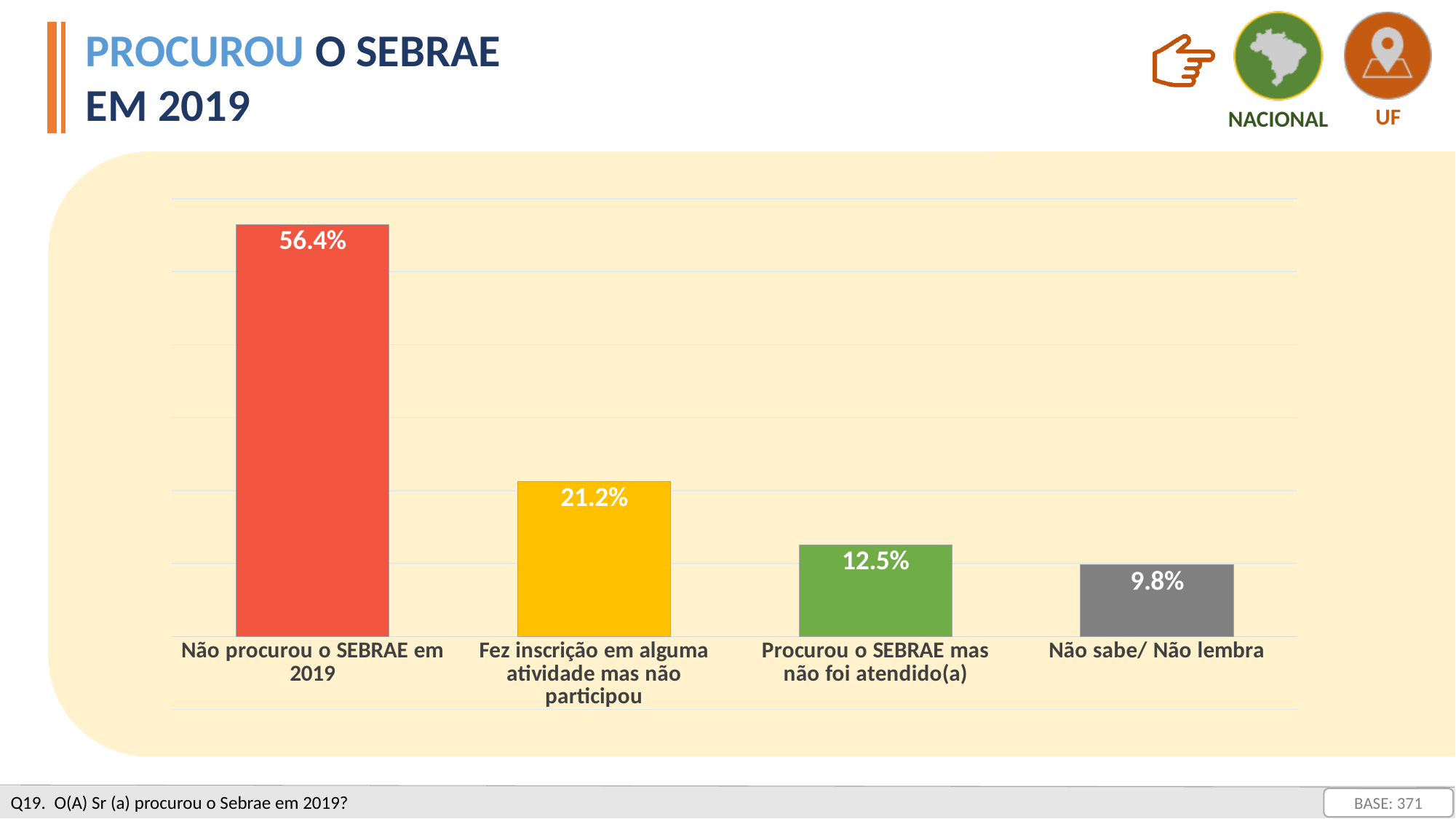
How many categories are shown in the chart? 4 What kind of chart is shown on the slide? Bar chart Which category has the highest value? Não procurou o SEBRAE em 2019 What is the value for "Fez inscrição em alguma atividade mas não participou"? 21.2% Which is larger: "Fez inscrição em alguma atividade mas não participou" or "Procurou o SEBRAE mas não foi atendido(a)"? Fez inscrição em alguma atividade mas não participou Do the values rise or fall from left to right across the categories? Fall Which category has the lowest value? Não sabe/ Não lembra What is the difference between "Não procurou o SEBRAE em 2019" and "Fez inscrição em alguma atividade mas não participou"? 35.2% What is the value for "Procurou o SEBRAE mas não foi atendido(a)"? 12.5% What is the difference between "Procurou o SEBRAE mas não foi atendido(a)" and "Não sabe/ Não lembra"? 2.7% What is the value for "Não procurou o SEBRAE em 2019"? 56.4% What is the value for "Não sabe/ Não lembra"? 9.8%